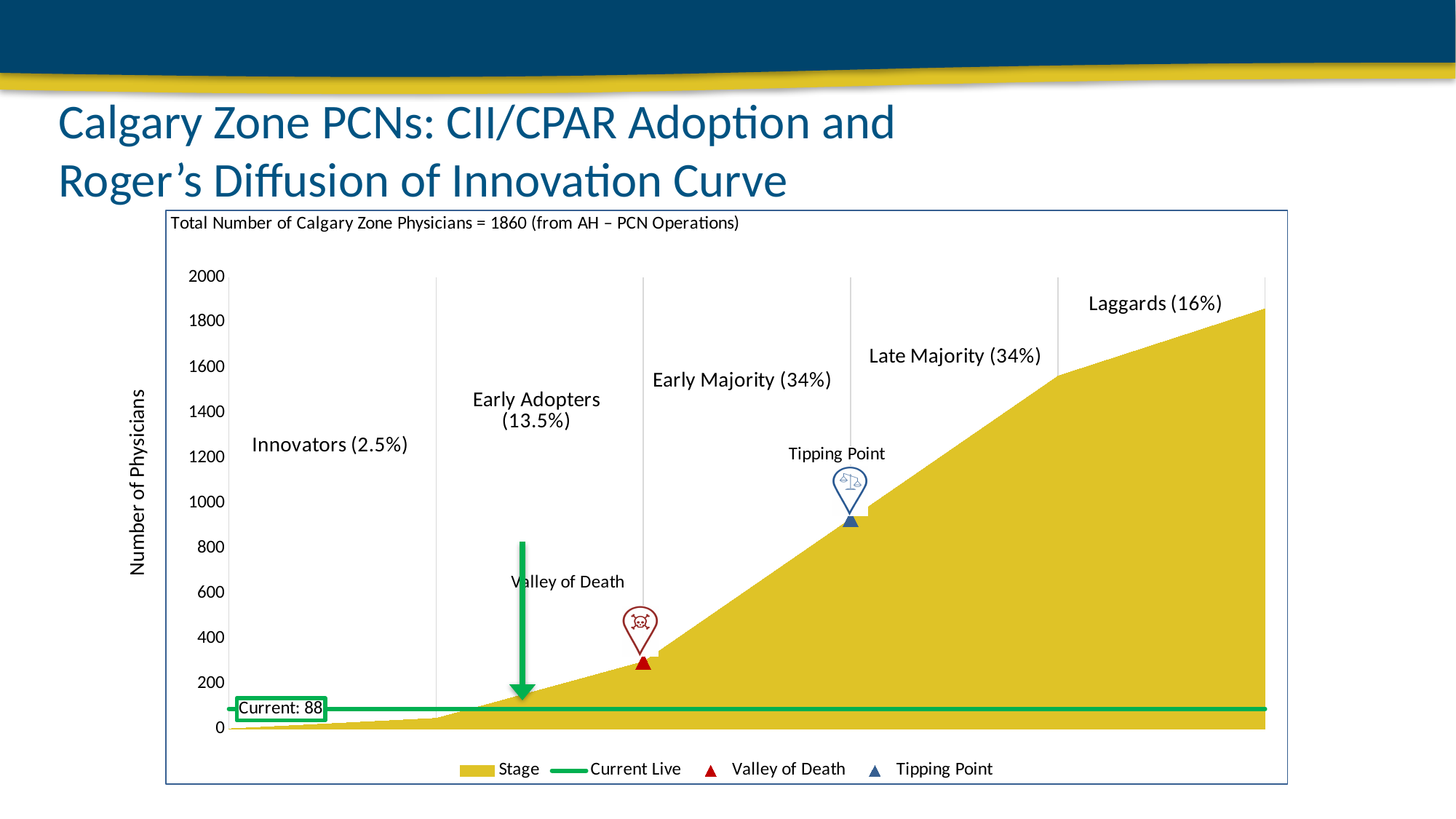
Is the Tipping Point marker greater or less than 800 physicians? greater What percentage is shown for the Laggards stage? 16% What total number of Calgary Zone physicians is stated in the chart title? 1860 Is the Valley of Death marker greater or less than 400 physicians? less What percentage is shown for the Early Adopters stage? 13.5% Does the Stage area rise or fall from left to right along the x axis? rise How many series does the legend list? 4 What percentage is shown for the Innovators stage? 2.5% What is the value shown for the Current Live line? 88 What is the label on the vertical axis? Number of Physicians How many adoption stages are labelled on the chart? 5 What colour is the Stage area in the chart? Yellow